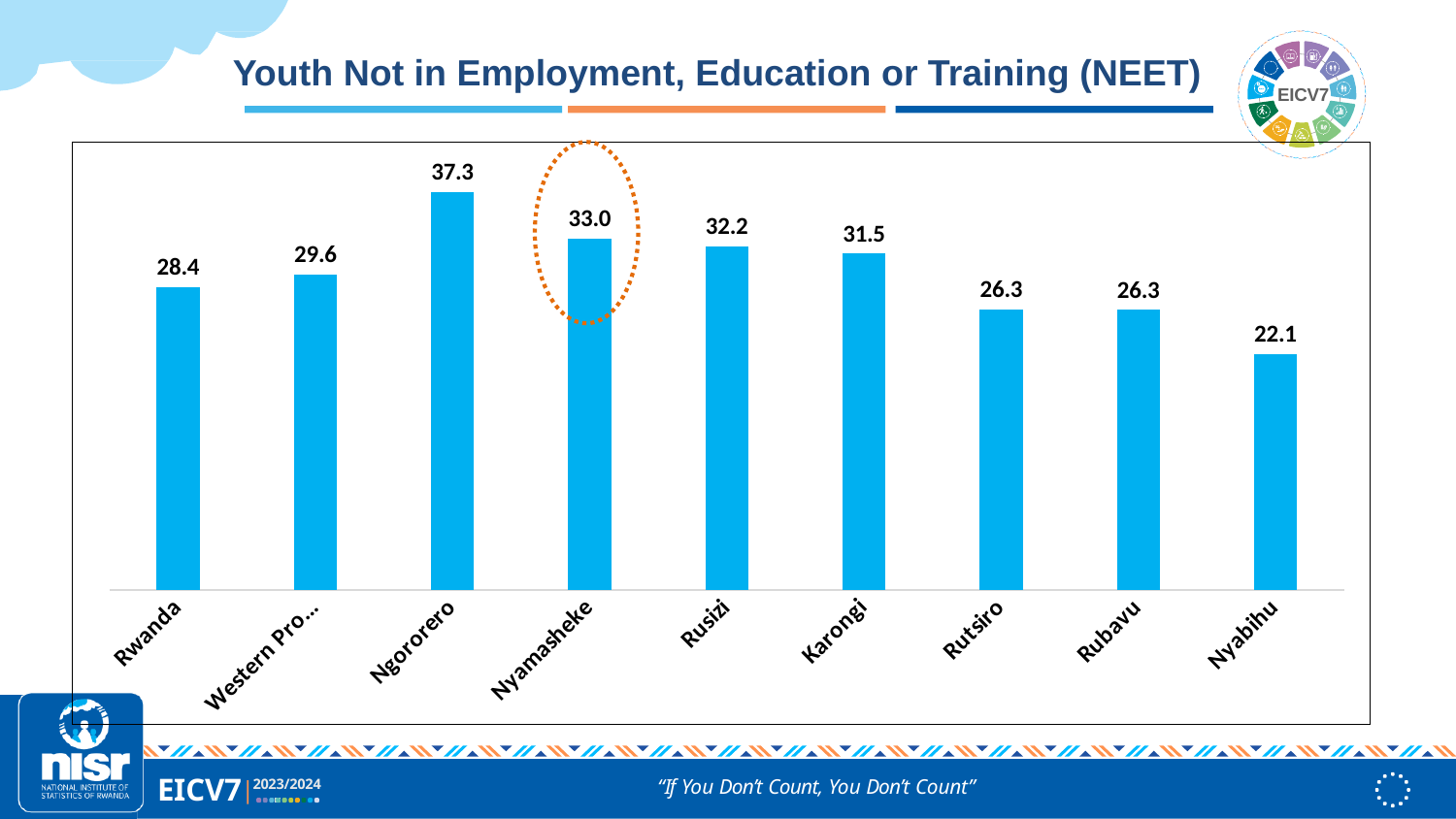
What kind of chart is shown on the slide? Bar chart Which has a higher NEET value, Rusizi or Karongi? Rusizi What is the NEET value for Rwanda? 28.4 What is the NEET value for Ngororero? 37.3 Which category has the highest NEET value? Ngororero How many bars are shown in the chart? 9 Which bar is highlighted with a dashed orange circle? Nyamasheke What is the NEET value for Nyamasheke? 33.0 What is the difference between the NEET values for Ngororero and Nyabihu? 15.2 What is the difference between the NEET values for Nyamasheke and Rwanda? 4.6 Which category has the lowest NEET value? Nyabihu What is the NEET value for Nyabihu? 22.1